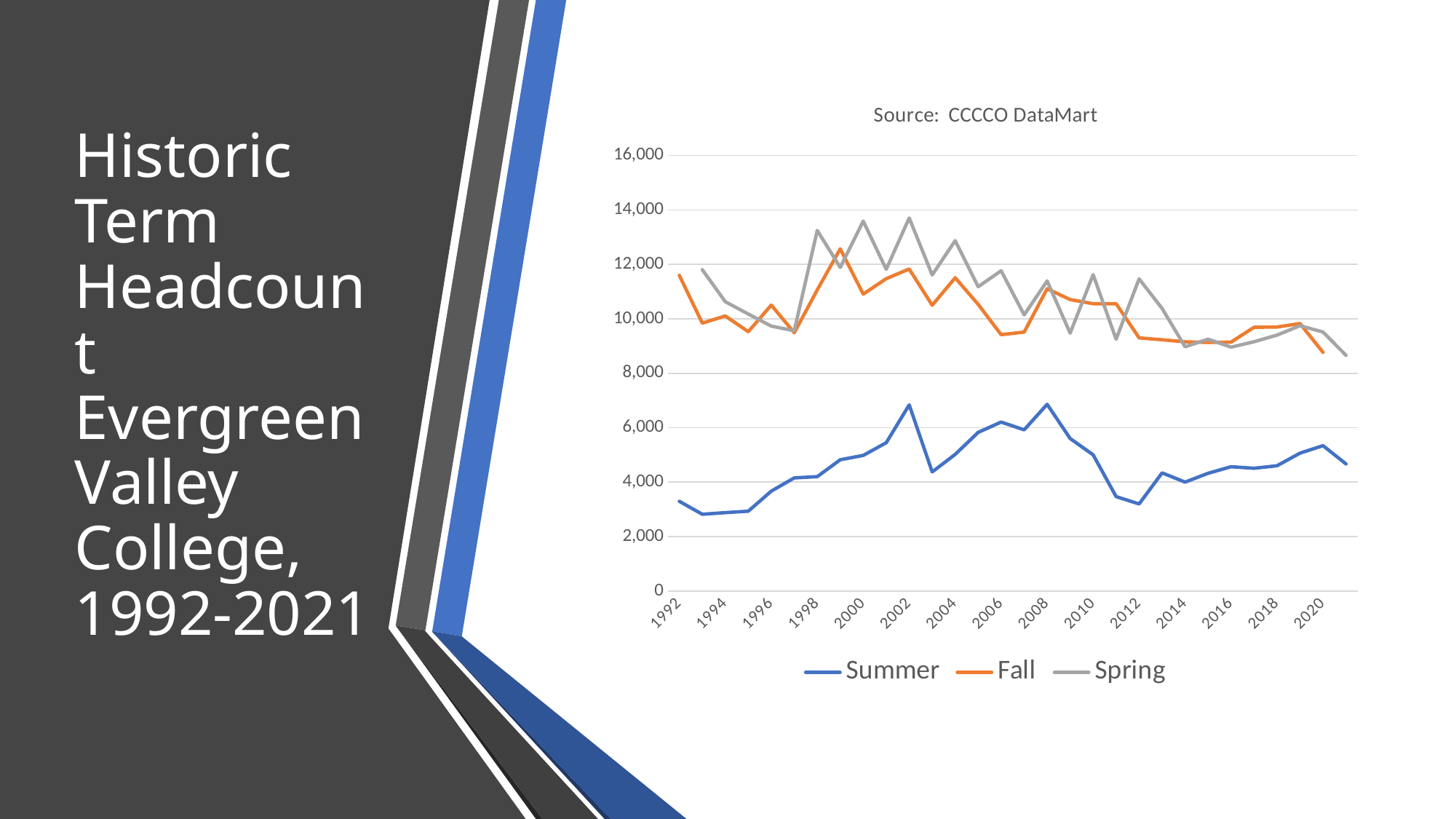
Which series has the lowest headcount across all years shown? Summer Does the Summer headcount generally rise or fall from 1992 to 2002? rise Is the Summer headcount in 2012 greater or less than 4,000? less What source is cited above the chart? CCCCO DataMart Is the Fall headcount in 1992 greater or less than 10,000? greater Is the Spring headcount in 2002 greater or less than 12,000? greater Which series does the legend show in blue? Summer How many series does the legend list? 3 What kind of chart is shown on the slide? line chart In 2000, which series has the larger headcount, Summer or Fall? Fall